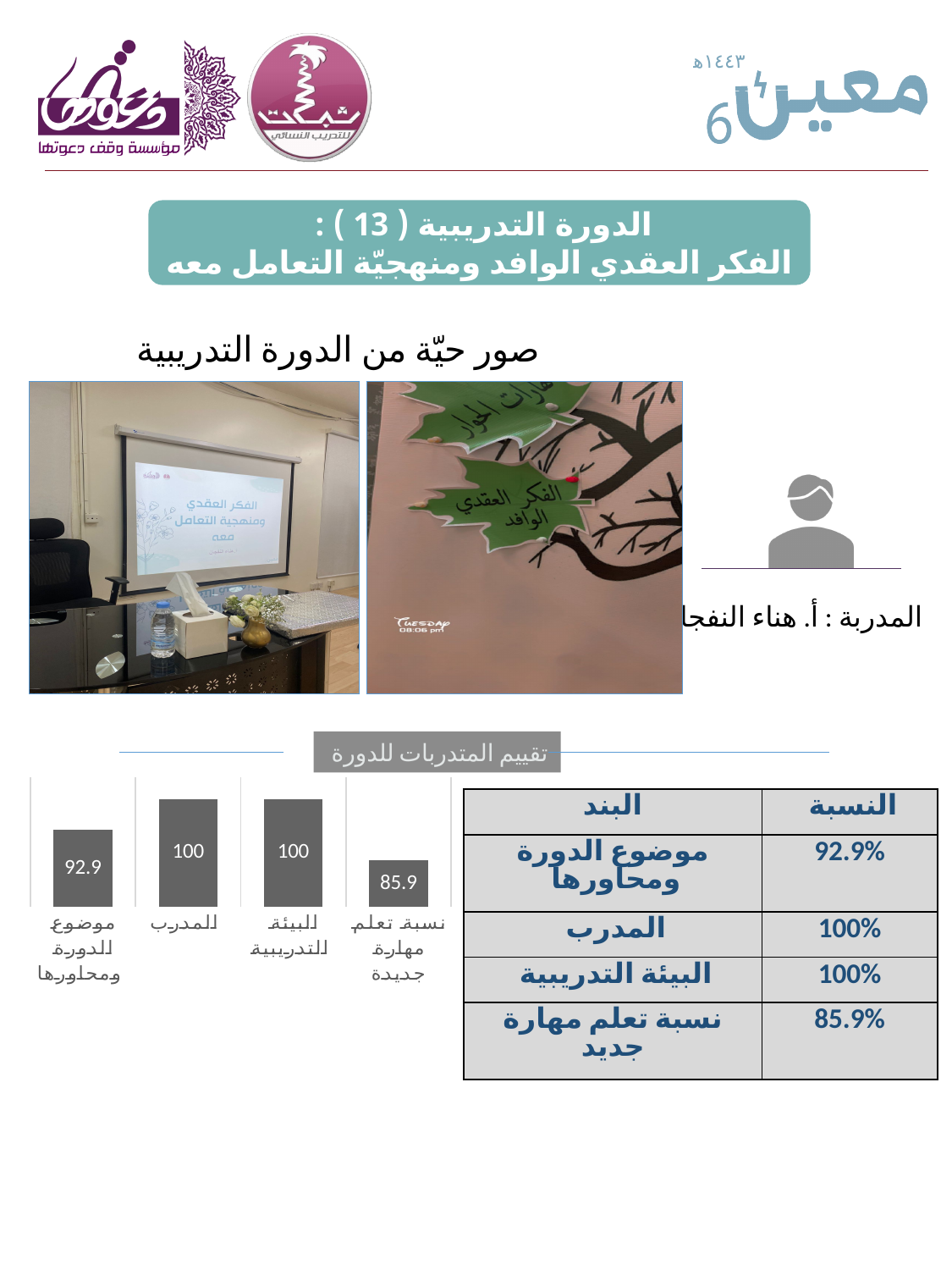
What is the value shown for البيئة التدريبية in the bar chart? 100 Which category has the lowest value in the bar chart? نسبة تعلم مهارة جديدة What type of chart is shown under the heading تقييم المتدربات للدورة? Bar chart What is the title shown above the bar chart? تقييم المتدربات للدورة How many categories are plotted in the bar chart? 4 What is the difference between the values for موضوع الدورة ومحاورها and نسبة تعلم مهارة جديدة in the bar chart? 7 What is the difference between the values for المدرب and نسبة تعلم مهارة جديدة in the bar chart? 14.1 Which is larger in the bar chart, the value for موضوع الدورة ومحاورها or the value for نسبة تعلم مهارة جديدة? موضوع الدورة ومحاورها Which is larger in the bar chart, the value for المدرب or the value for موضوع الدورة ومحاورها? المدرب What is the value shown for نسبة تعلم مهارة جديدة in the bar chart? 85.9 What is the value shown for موضوع الدورة ومحاورها in the bar chart? 92.9 What is the value shown for المدرب in the bar chart? 100